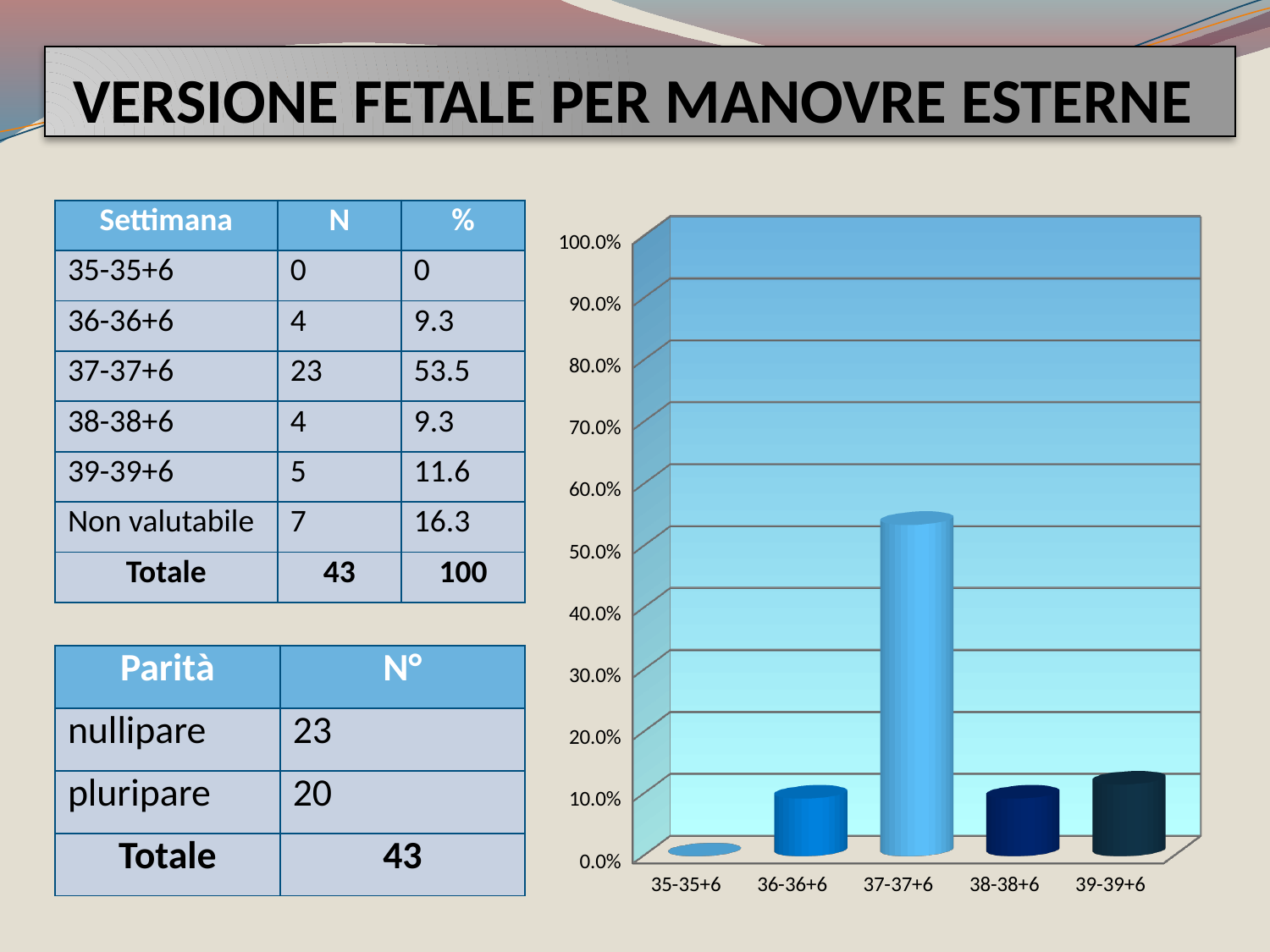
Which category has the lowest bar in the chart? 35-35+6 What is the label of the leftmost category on the x axis of the chart? 35-35+6 Is the value for 39-39+6 greater or less than 20.0%? less Which is larger in the chart, the value for 37-37+6 or the value for 38-38+6? 37-37+6 What is the highest tick label on the y axis of the chart? 100.0% Is the value for 36-36+6 greater or less than 20.0%? less What value does the bar for 35-35+6 show in the chart? 0.0% Is the value for 38-38+6 greater or less than 30.0%? less Which category has the highest bar in the chart? 37-37+6 How many categories are shown on the x axis of the chart? 5 What kind of chart is shown on the slide? bar chart